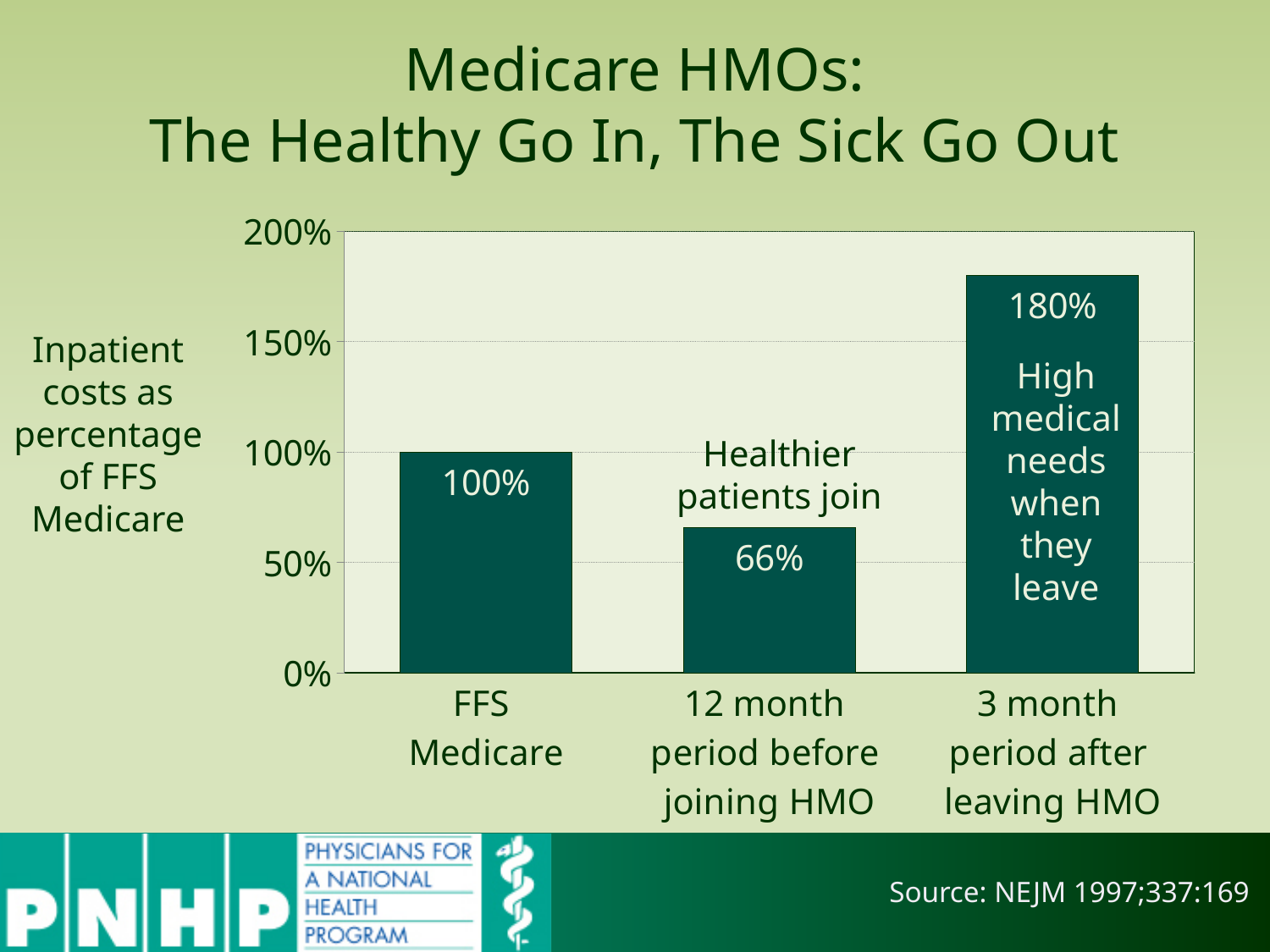
What kind of chart is shown on the slide? Bar chart What is the difference between the value for the 3 month period after leaving HMO and the value for FFS Medicare? 80% Which category has the lowest value? 12 month period before joining HMO What is the value for the 12 month period before joining HMO? 66% How many categories are shown on the chart? 3 What is the difference between the value for FFS Medicare and the value for the 12 month period before joining HMO? 34% Which category has the highest value? 3 month period after leaving HMO Is the value for the 3 month period after leaving HMO greater or less than 150%? greater What is the value for FFS Medicare? 100% Which is larger: the value for the 12 month period before joining HMO or the value for the 3 month period after leaving HMO? 3 month period after leaving HMO What is the value for the 3 month period after leaving HMO? 180% What is the title of the slide containing the chart? Medicare HMOs: The Healthy Go In, The Sick Go Out